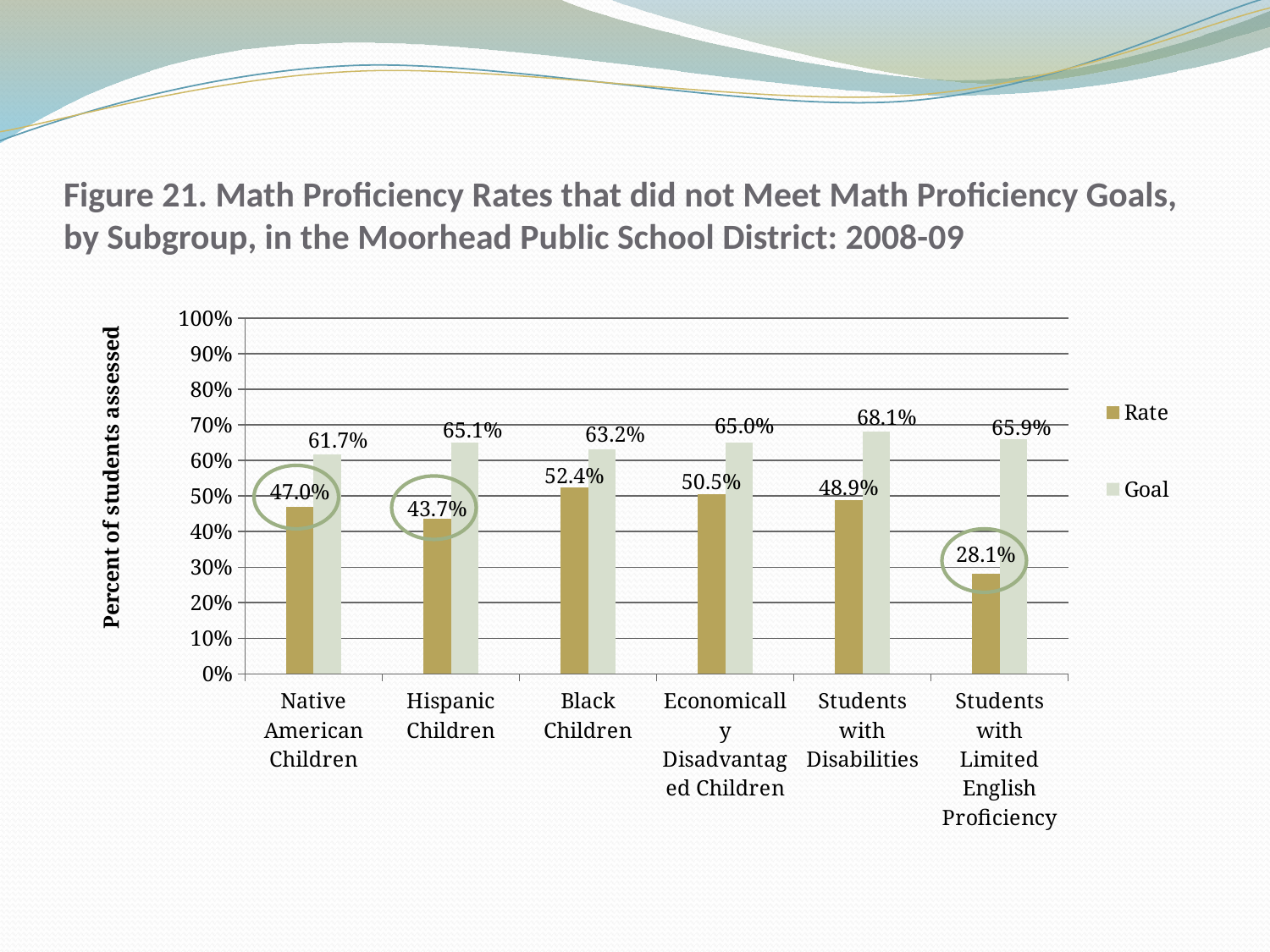
What is the Goal value for Students with Disabilities? 68.1% What kind of chart is shown on the slide? Bar chart Which subgroup has the lowest Goal value? Native American Children How many series does the legend list? 2 What is the Rate value for Students with Limited English Proficiency? 28.1% How many subgroups are shown on the x axis? 6 Which subgroup has the highest Rate value? Black Children What is the Rate value for Hispanic Children? 43.7% What is the difference between the Goal and the Rate for Students with Limited English Proficiency? 37.8% Which subgroup has the lowest Rate value? Students with Limited English Proficiency Which is larger, the Rate for Native American Children or the Rate for Economically Disadvantaged Children? Economically Disadvantaged Children Is the Rate value for Black Children greater or less than 50%? greater